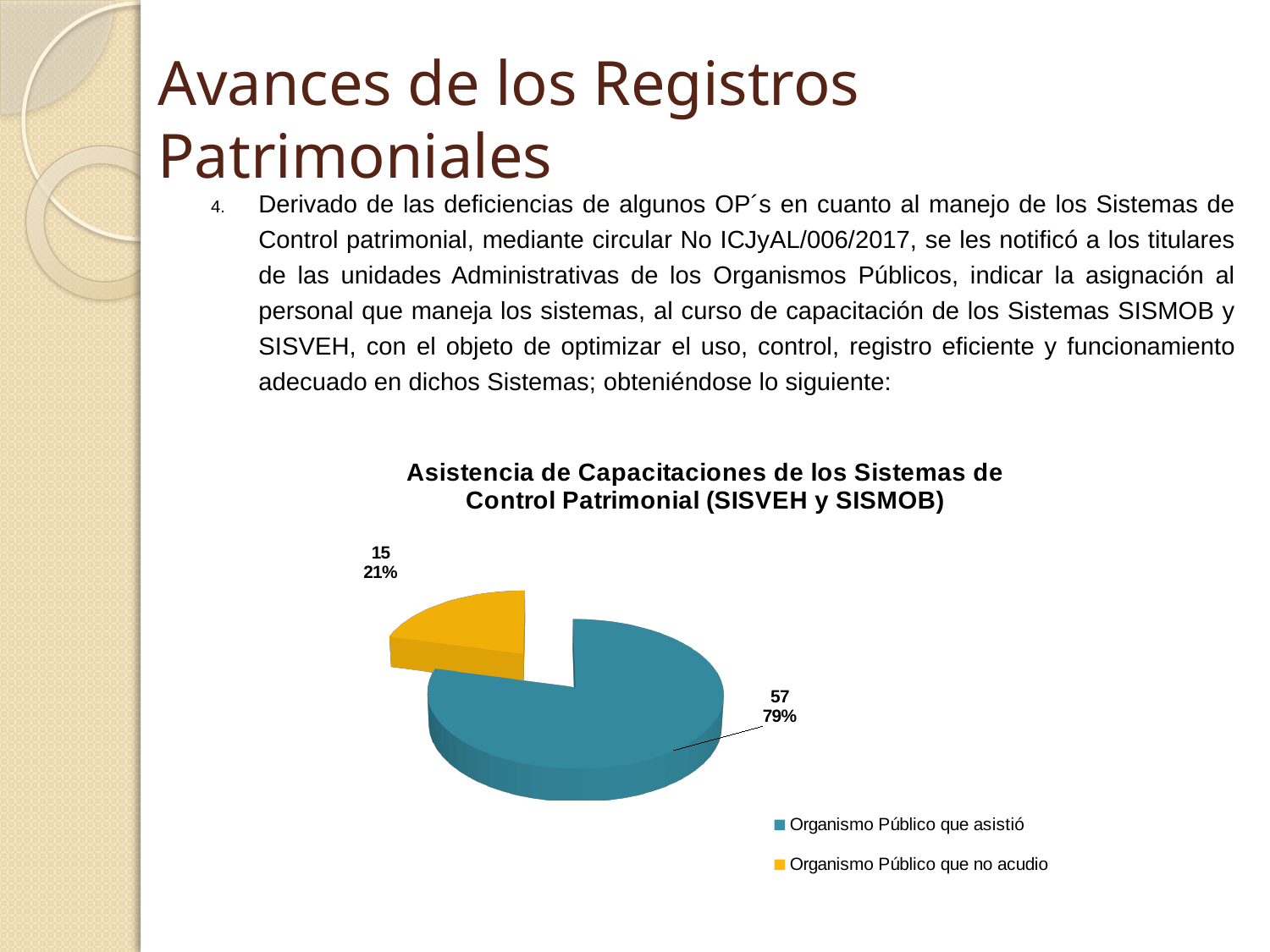
What is the value for 'Organismo Público que no acudio'? 15 How many slices does the pie chart have? 2 What share of the pie does 'Organismo Público que no acudio' represent? 21% What is the title of the chart? Asistencia de Capacitaciones de los Sistemas de Control Patrimonial (SISVEH y SISMOB) What is the difference between the values for 'Organismo Público que asistió' and 'Organismo Público que no acudio'? 42 Which category has the smallest slice? Organismo Público que no acudio How many entries does the legend list? 2 What share of the pie does 'Organismo Público que asistió' represent? 79% Which category has the largest slice? Organismo Público que asistió What is the value for 'Organismo Público que asistió'? 57 What kind of chart is shown on the slide? pie chart What is the total of the two slices in the pie chart? 72